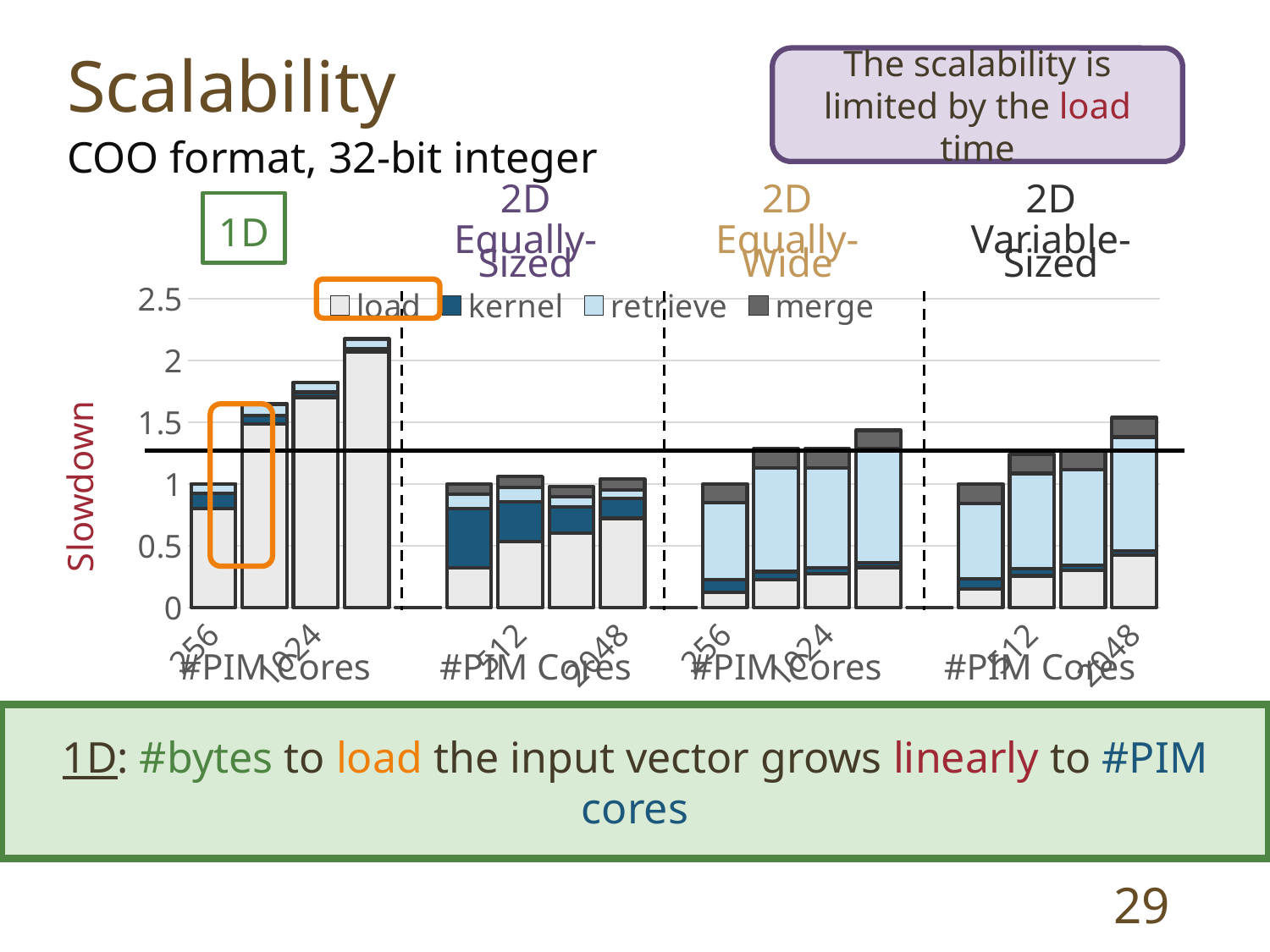
In the 1D group, is the total slowdown for 2048 PIM cores greater or less than 2? greater Which bar in the whole chart has the highest total slowdown? 1D, 2048 PIM cores How many bars are plotted in the chart in total? 16 What is the label of the y axis? Slowdown In the 1D group, do the stacked bar totals rise or fall as the number of PIM cores increases? rise What are the four series listed in the legend? load, kernel, retrieve, merge How many groups of bars (partitioning schemes) are shown in the chart? 4 In the 2D Equally-Wide group, is the total slowdown for 2048 PIM cores greater or less than 1? greater Which is larger: the total slowdown for 2048 PIM cores in the 1D group or in the 2D Equally-Sized group? 1D How many series does the legend list? 4 What kind of chart is shown on the slide? bar chart In the 1D group, is the total slowdown for 512 PIM cores greater or less than 1.5? greater